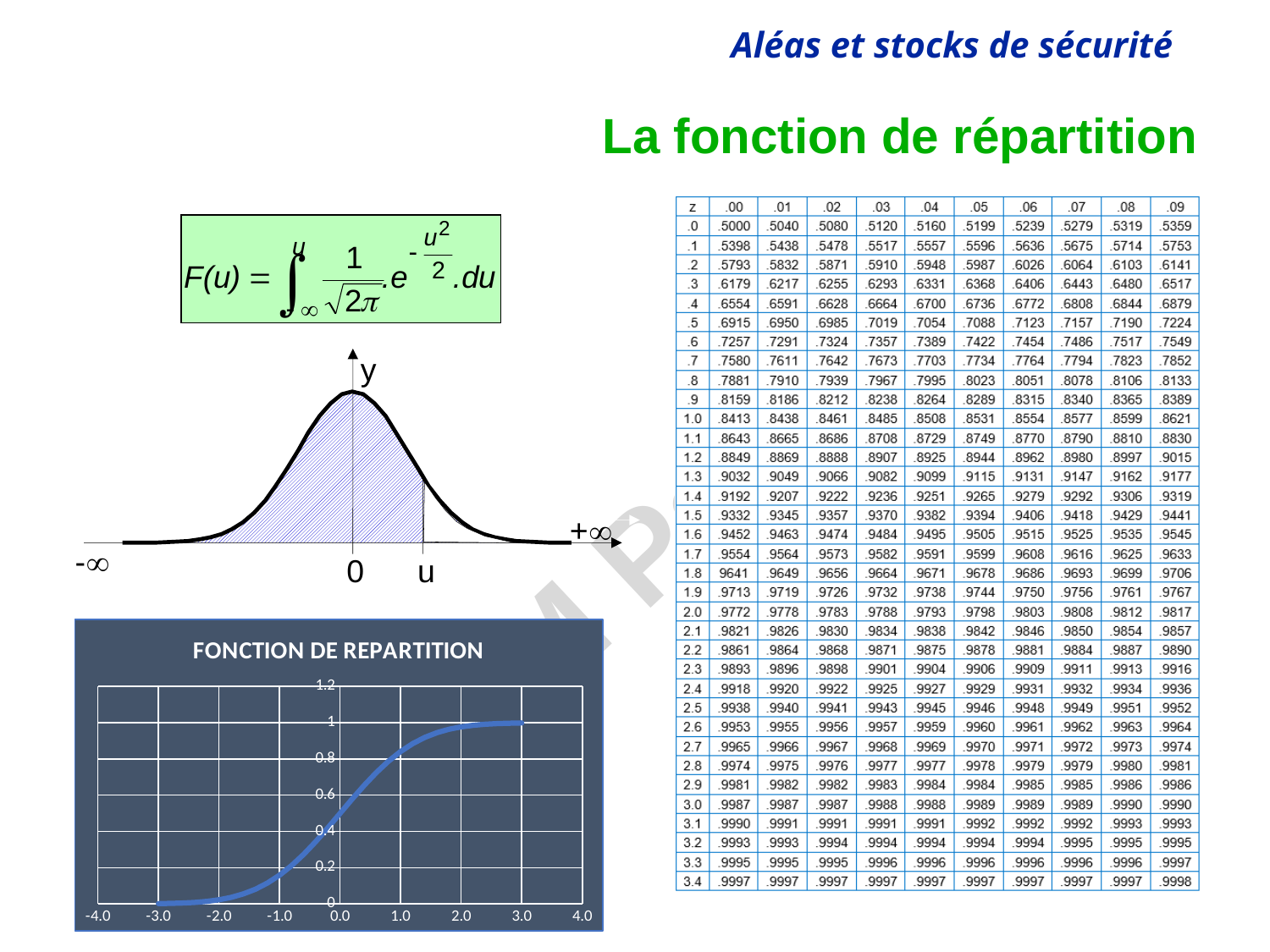
In the "FONCTION DE REPARTITION" chart, is the value at x = 1.0 greater or less than 0.6? greater In the "FONCTION DE REPARTITION" chart, is the value at x = 0.0 greater or less than 0.8? less In the "FONCTION DE REPARTITION" chart, do the values rise or fall as x increases from -4.0 to 4.0? rise What kind of chart is the "FONCTION DE REPARTITION" chart? line chart In the "FONCTION DE REPARTITION" chart, is the value at x = -2.0 greater or less than 0.2? less What is the title of the line chart at the bottom left of the slide? FONCTION DE REPARTITION In the "FONCTION DE REPARTITION" chart, which is larger: the value at x = 3.0 or the value at x = -3.0? the value at x = 3.0 What is the highest value shown on the y axis of the "FONCTION DE REPARTITION" chart? 1.2 How many tick labels are shown on the x axis of the "FONCTION DE REPARTITION" chart? 9